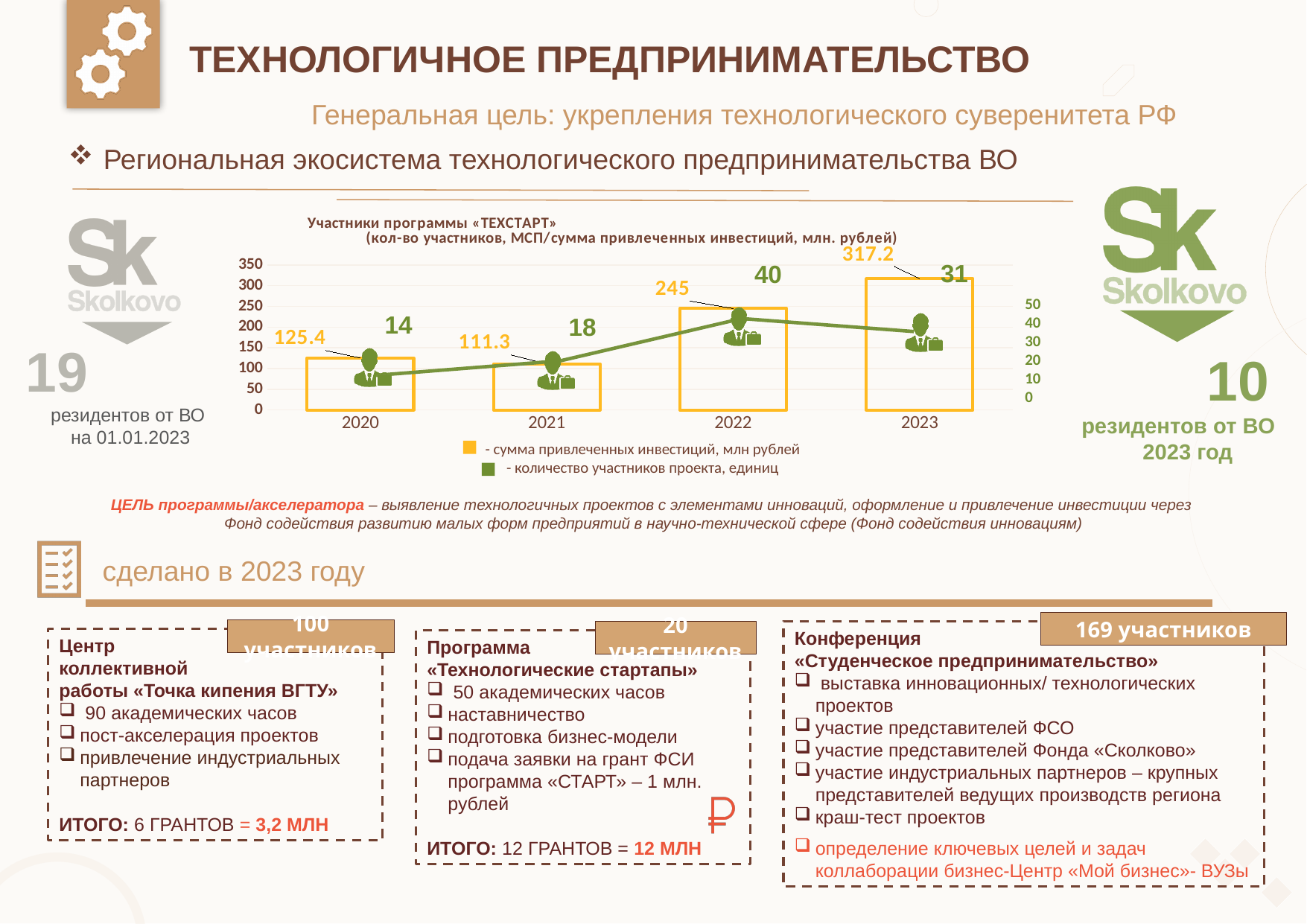
What is the sum of attracted investments for 2023 in the «ТЕХСТАРТ» chart? 317.2 In which year is the number of project participants highest in the «ТЕХСТАРТ» chart? 2022 In which year is the sum of attracted investments highest in the «ТЕХСТАРТ» chart? 2023 In which year is the sum of attracted investments lowest in the «ТЕХСТАРТ» chart? 2021 How many years are shown on the x axis of the «ТЕХСТАРТ» chart? 4 How many project participants does the «ТЕХСТАРТ» chart show for 2021? 18 How many series does the legend of the «ТЕХСТАРТ» chart list? 2 Which year has a larger sum of attracted investments in the «ТЕХСТАРТ» chart, 2020 or 2021? 2020 What is the difference in the number of participants between 2022 and 2023 in the «ТЕХСТАРТ» chart? 9 Which colour represents the sum of attracted investments in the «ТЕХСТАРТ» chart? Yellow What is the sum of attracted investments (млн рублей) for 2022 in the «ТЕХСТАРТ» chart? 245 By how much did the sum of attracted investments increase from 2022 to 2023 in the «ТЕХСТАРТ» chart? 72.2